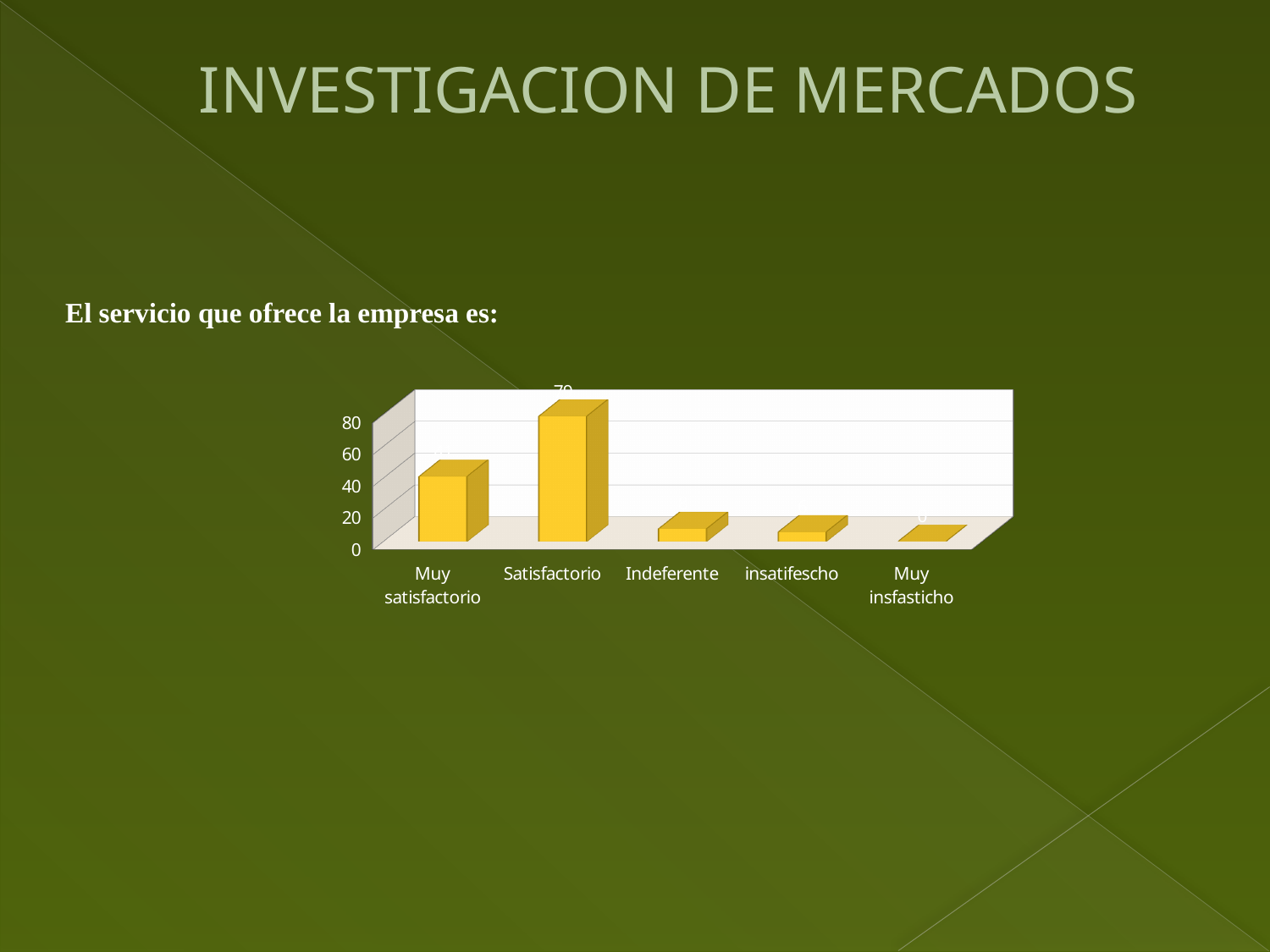
Is the value for insatifescho greater or less than 40? less Is the value for Indeferente greater or less than 20? less What kind of chart is shown on the slide? bar chart What question or statement is written above the chart? El servicio que ofrece la empresa es: What is the value shown for Muy insfasticho? 0 Which is larger, the value for Muy satisfactorio or the value for Satisfactorio? Satisfactorio Is the value for Satisfactorio greater or less than 60? greater What is the value shown for Satisfactorio? 79 Which category has the lowest bar in the chart? Muy insfasticho How many categories are shown on the x axis of the chart? 5 Which category has the highest bar in the chart? Satisfactorio